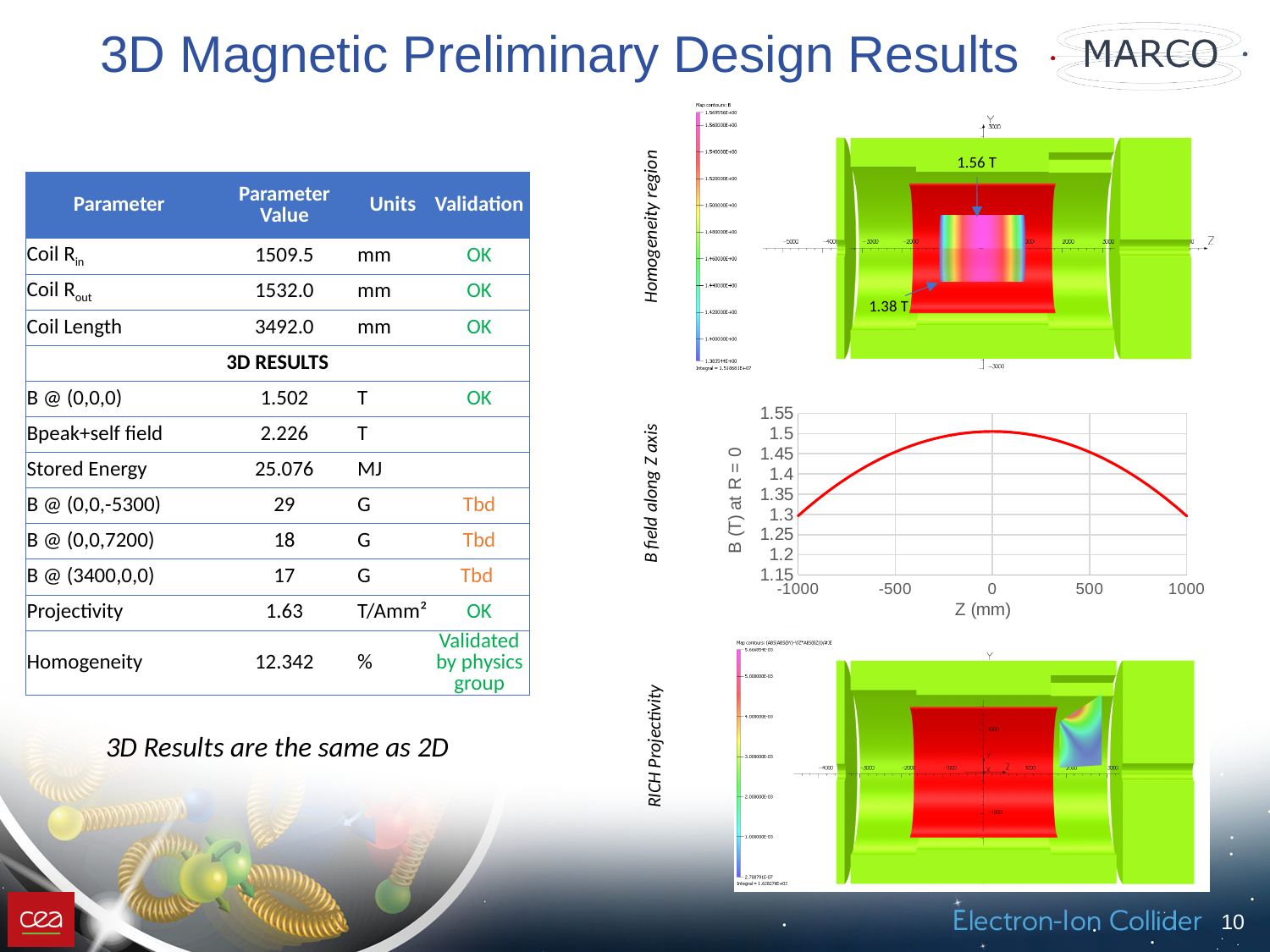
In the 'B field along Z axis' chart, does the curve rise or fall as Z goes from 0 to 1000? fall In the 'B field along Z axis' chart, does the curve rise or fall as Z goes from -1000 to 0? rise In the 'B field along Z axis' chart, what kind of chart is shown? line chart In the 'B field along Z axis' chart, is the value at Z = 500 greater or less than 1.4? greater In the 'B field along Z axis' chart, at which Z value does the curve reach its highest point? 0 In the 'B field along Z axis' chart, what is the label of the y axis? B (T) at R = 0 In the 'B field along Z axis' chart, what is the lowest value shown on the y axis? 1.15 In the 'B field along Z axis' chart, is the value at Z = 0 greater or less than 1.45? greater In the 'B field along Z axis' chart, is the value at Z = 1000 greater or less than 1.4? less In the 'B field along Z axis' chart, what is the label of the x axis? Z (mm) In the 'B field along Z axis' chart, which is larger: the value at Z = 0 or the value at Z = 1000? Z = 0